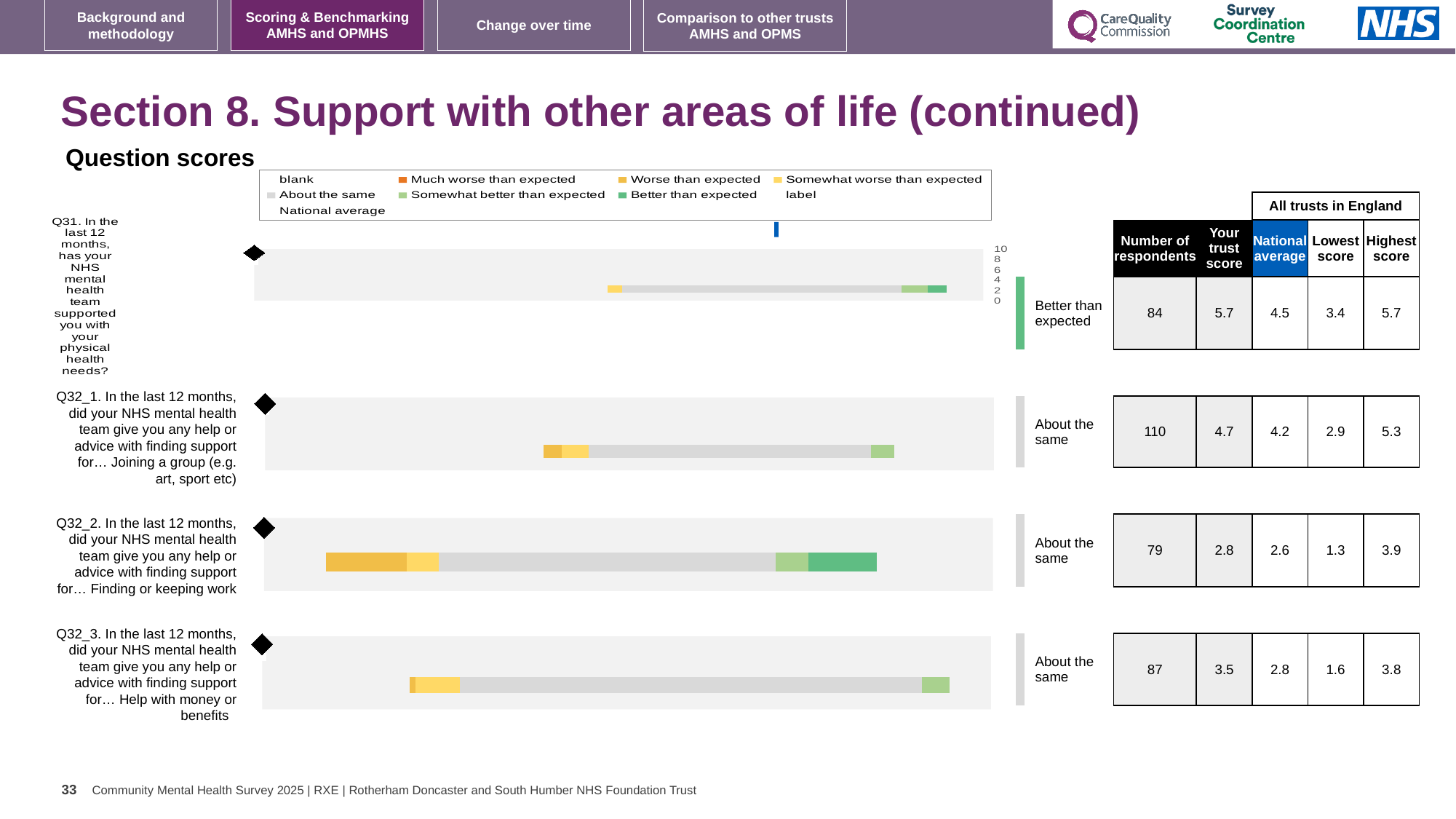
For Q31, what is the difference between the highest score and the lowest score among all trusts in England? 2.3 How many respondents are listed for Q32_1 (help with joining a group)? 110 How many questions (bars) are shown in the question scores chart? 4 What benchmark category is shown for Q31 (support with physical health needs)? Better than expected For Q32_2 (finding or keeping work), which is larger: the trust score or the national average? Your trust score What kind of chart is used to show the question scores on this slide? Bar chart Which question has the highest 'Your trust score'? Q31 What is the highest score among all trusts in England for Q32_3 (help with money or benefits)? 3.8 What is the 'Your trust score' for Q31 (support with physical health needs)? 5.7 What benchmark category is shown for Q32_3 (help with money or benefits)? About the same Which question has the lowest number of respondents? Q32_2 What is the national average for Q32_2 (finding or keeping work)? 2.6